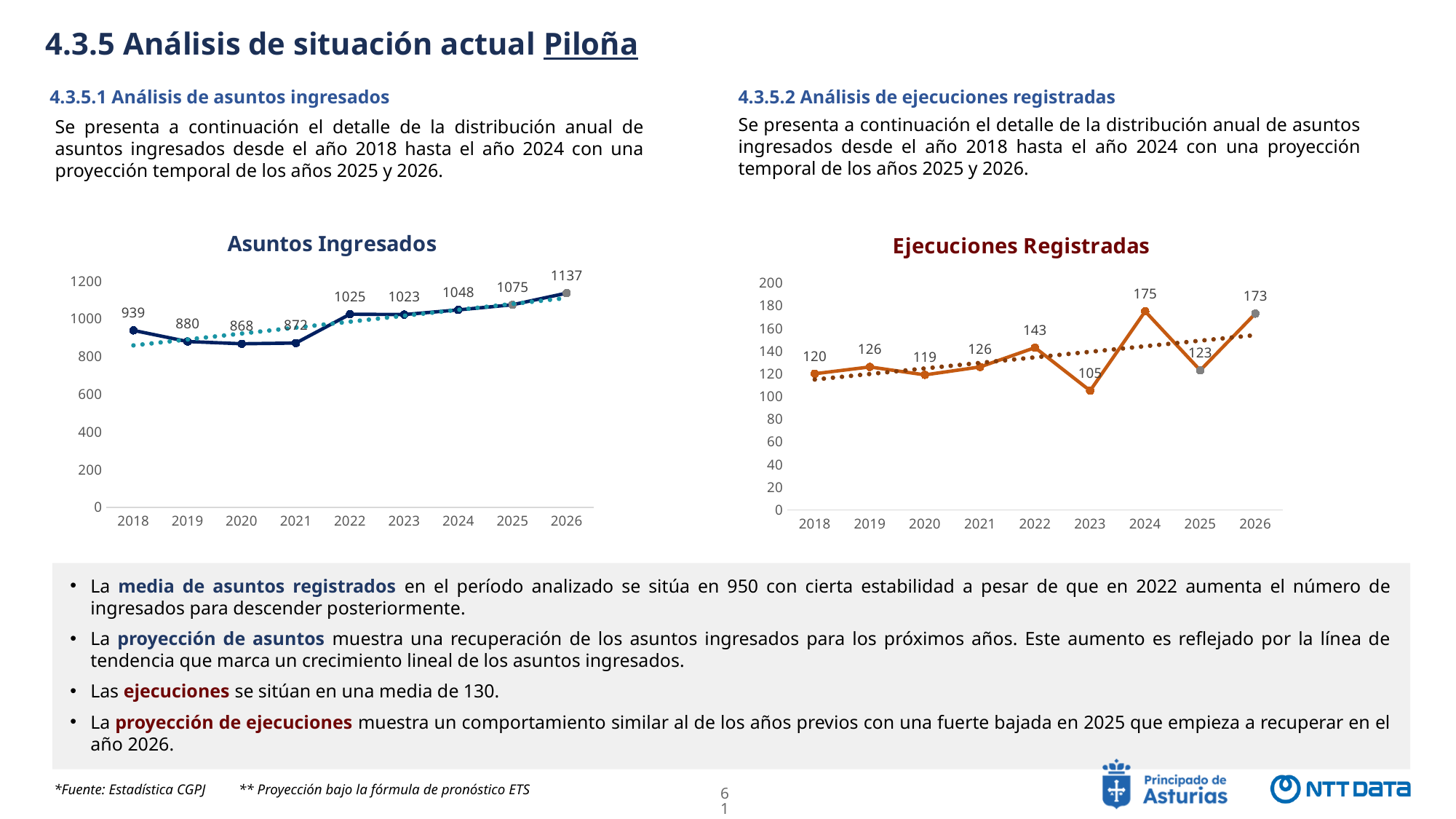
In the 'Asuntos Ingresados' chart, what is the difference between the values for 2022 and 2021? 153 In the 'Ejecuciones Registradas' chart, what is the value for 2022? 143 In the 'Ejecuciones Registradas' chart, which year has the highest value? 2024 What kind of chart is 'Asuntos Ingresados'? Line chart In the 'Ejecuciones Registradas' chart, which year has the lowest value? 2023 In the 'Asuntos Ingresados' chart, which year has the lowest value? 2020 In the 'Ejecuciones Registradas' chart, is the value for 2019 larger or the value for 2020? 2019 In the 'Asuntos Ingresados' chart, how many years are shown on the x axis? 9 In the 'Asuntos Ingresados' chart, what is the value for 2018? 939 In the 'Asuntos Ingresados' chart, do the values rise or fall from 2021 to 2026? Rise In the 'Ejecuciones Registradas' chart, what is the difference between the values for 2024 and 2025? 52 In the 'Asuntos Ingresados' chart, what is the value for 2026? 1137